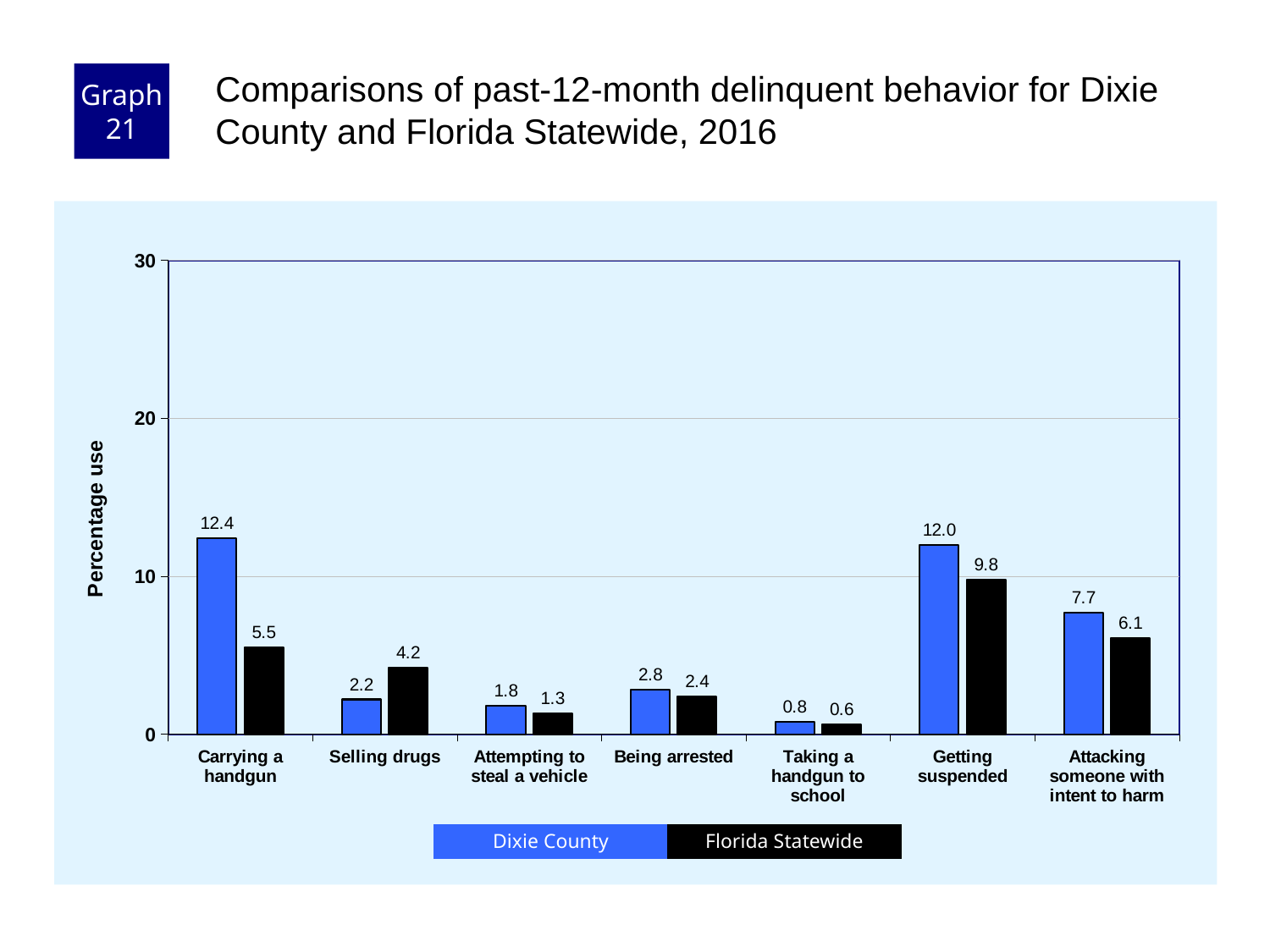
Which category has the lowest Florida Statewide value? Taking a handgun to school How many series does the legend list? 2 What is the difference between the Dixie County and Florida Statewide values for Carrying a handgun? 6.9 What kind of chart is shown on the slide? Bar chart Which category has the highest Dixie County value? Carrying a handgun How many categories are shown on the x axis? 7 What is the Dixie County value for Carrying a handgun? 12.4 Which is larger for Selling drugs: the Dixie County value or the Florida Statewide value? Florida Statewide Is the Dixie County value for Getting suspended greater or less than 10? greater What is the Dixie County value for Taking a handgun to school? 0.8 What is the label of the y axis? Percentage use What is the Florida Statewide value for Getting suspended? 9.8